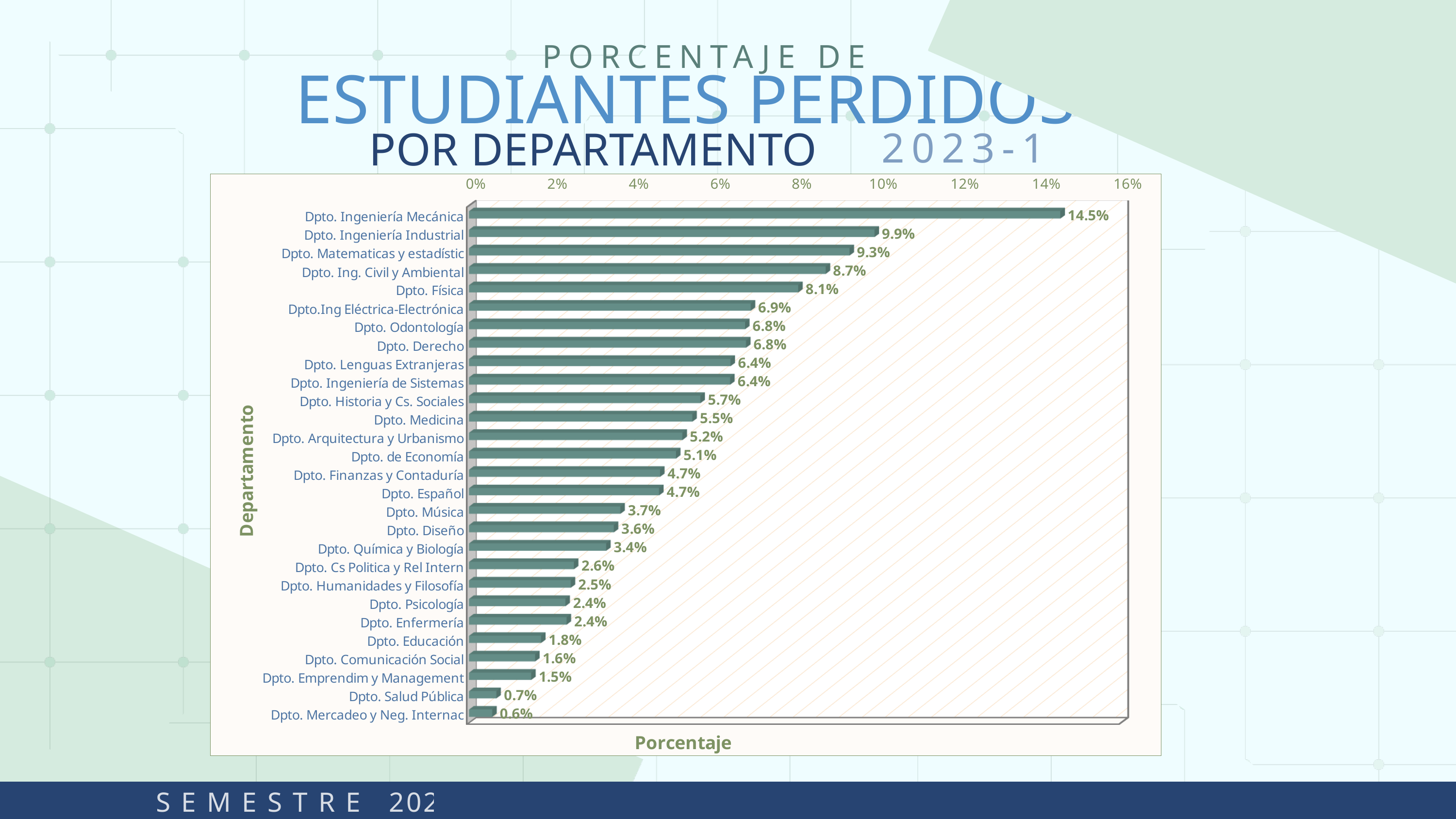
Which department has the highest percentage? Dpto. Ingeniería Mecánica What is the value for Dpto. Ingeniería Mecánica? 14.5% What is the difference between the values for Dpto. Ingeniería Mecánica and Dpto. Ingeniería Industrial? 4.6% Which is larger, the value for Dpto. Música or the value for Dpto. Química y Biología? Dpto. Música What is the value for Dpto. Física? 8.1% Which department has the lowest percentage? Dpto. Mercadeo y Neg. Internac How many departments are shown in the chart? 28 What is the value for Dpto. Salud Pública? 0.7% What is the value for Dpto. Medicina? 5.5% What kind of chart is shown on the slide? bar chart Is the value for Dpto. Ing. Civil y Ambiental greater or less than 8%? greater What is the label of the horizontal axis? Porcentaje